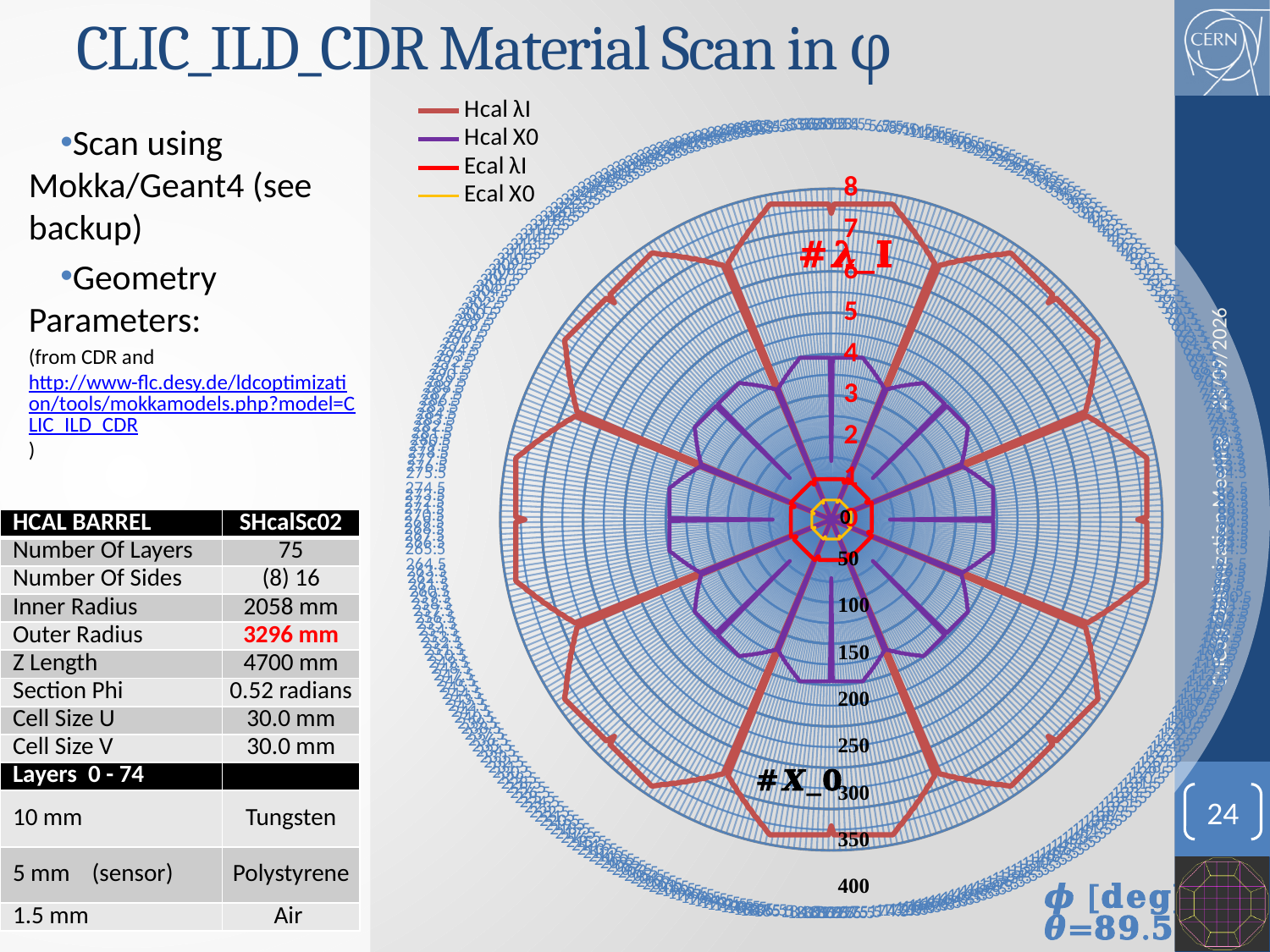
Which series reaches larger values, Hcal λI or Ecal λI? Hcal λI Which series stays closest to the centre of the radar chart? Ecal X0 Which series extends furthest from the centre of the radar chart? Hcal λI What are the four series listed in the chart legend? Hcal λI, Hcal X0, Ecal λI, Ecal X0 What is the highest tick label shown on the λI radial scale of the chart? 8 What kind of chart is shown on the slide? Radar chart How many series does the chart legend list? 4 Which series reaches larger values, Hcal X0 or Ecal X0? Hcal X0 Is the maximum value of the Hcal λI series greater or less than 5 on the λI scale? greater Is the value of the Ecal λI series greater or less than 2 on the λI scale? less